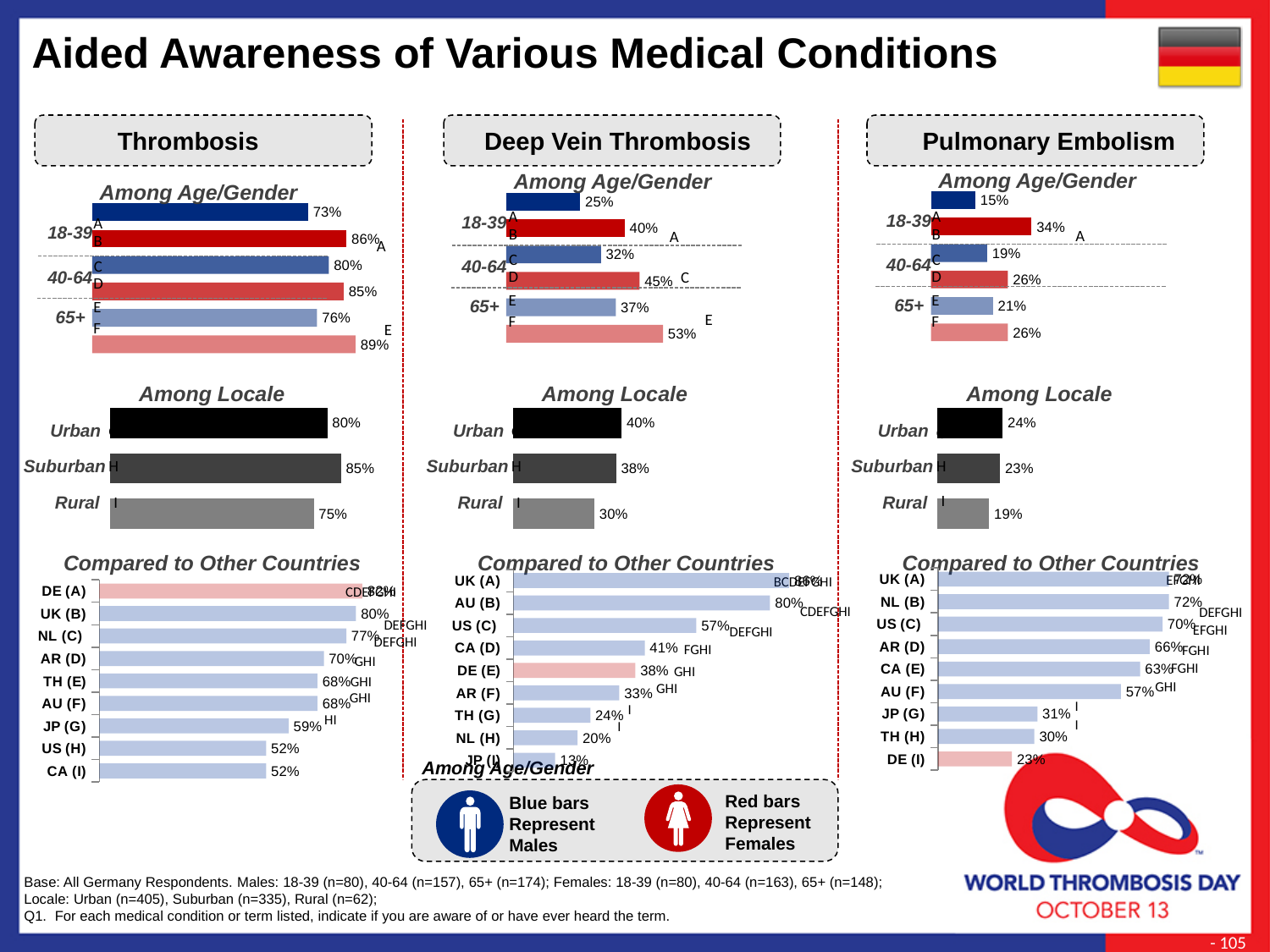
In the Thrombosis 'Among Age/Gender' chart, what is the value for bar F (65+ females)? 89% In the Pulmonary Embolism 'Among Age/Gender' chart, which bar has the highest value? B In the Pulmonary Embolism 'Among Locale' chart, what is the value for Rural? 19% According to the legend at the bottom of the slide, what do the red bars represent? Females In the Deep Vein Thrombosis 'Among Age/Gender' chart, what is the difference between bar F and bar E? 16% In the Deep Vein Thrombosis 'Among Locale' chart, which locale has the lowest value? Rural In the Thrombosis 'Among Locale' chart, what is the value for Suburban? 85% In the Thrombosis 'Compared to Other Countries' chart, which is larger, the value for UK (B) or the value for JP (G)? UK (B) In the Pulmonary Embolism 'Compared to Other Countries' chart, what is the value for DE (I)? 23% What type of chart is the Deep Vein Thrombosis 'Among Locale' chart? Bar chart In the Deep Vein Thrombosis 'Compared to Other Countries' chart, what is the value for JP (I)? 13% In the Pulmonary Embolism 'Compared to Other Countries' chart, how many countries are listed? 9